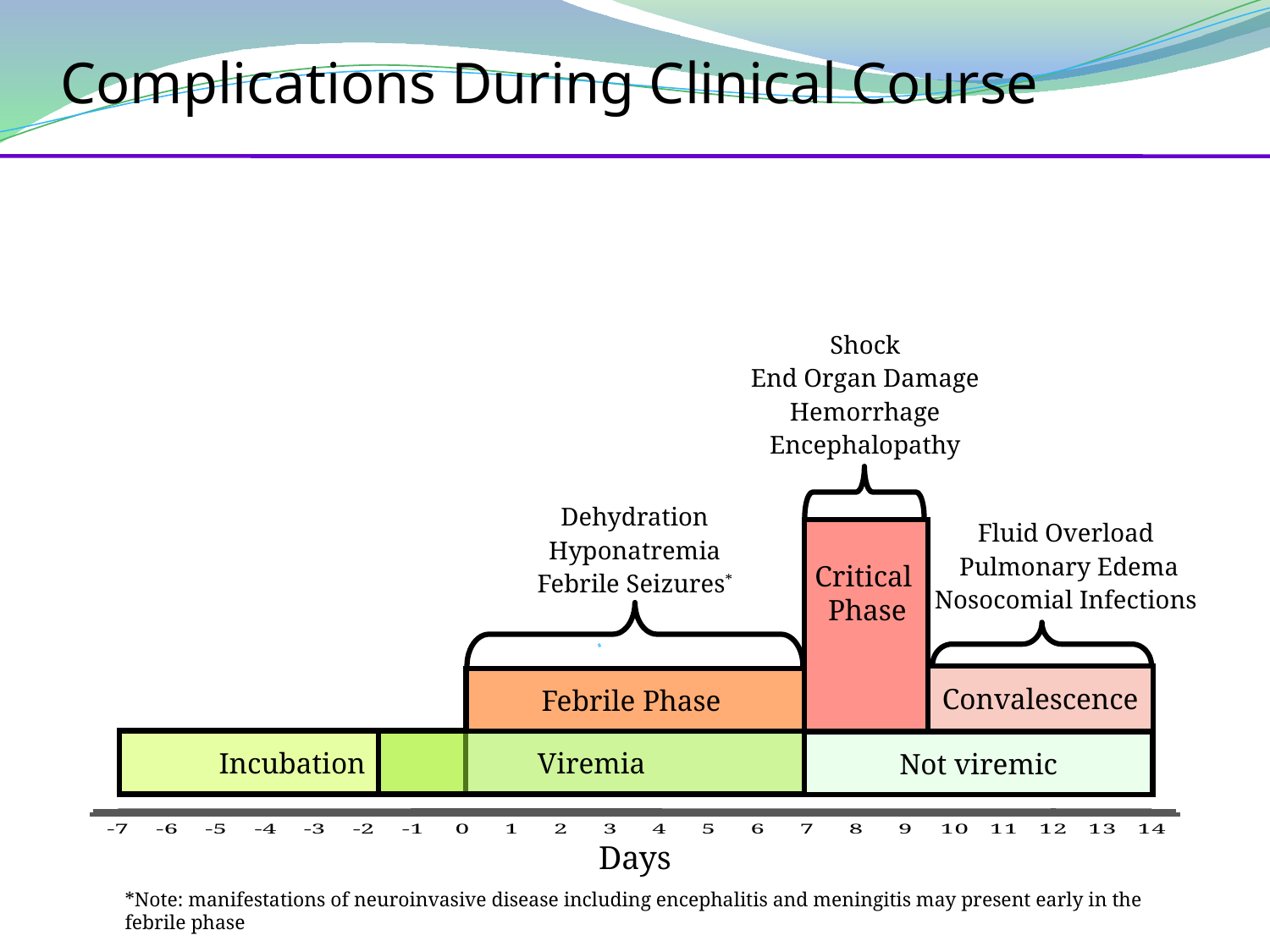
On what day does the Febrile Phase begin? 0 Which complications are listed above the Convalescence phase? Fluid Overload, Pulmonary Edema, Nosocomial Infections What is the label of the horizontal axis on the diagram? Days On what day does the Viremia period end? 7 Which phase is shown in the upper row between the Febrile Phase and Convalescence? Critical Phase What is the title of the slide containing the diagram? Complications During Clinical Course What is the lowest value shown on the Days axis? -7 How many complications are listed above the Critical Phase? 4 How many complications are listed above the Febrile Phase? 3 What is the highest value shown on the Days axis? 14 Which period in the lower row follows Viremia? Not viremic On what day does the Febrile Phase end and the Critical Phase begin? 7